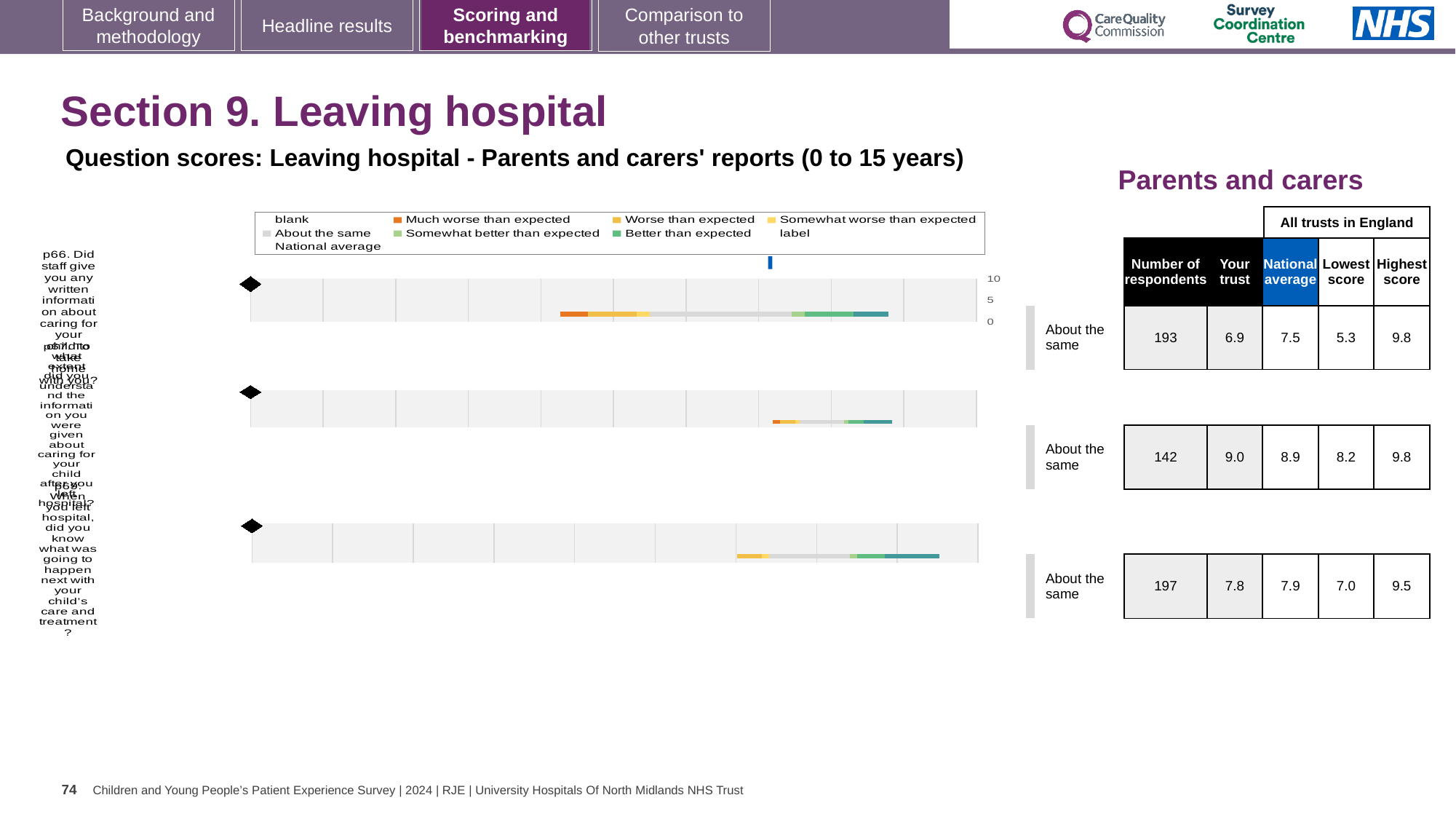
In the Parents and carers table, what is the difference between the highest score and the lowest score for the first question (193 respondents)? 4.5 In the Parents and carers table, what is the national average for the second question (142 respondents)? 8.9 In the Parents and carers table, what benchmark category is given for each of the three questions? About the same How many separate question charts are shown on the slide? 3 In the Parents and carers table, is the 'Your trust' score for the second question (142 respondents) larger or smaller than its national average? larger What kind of chart is used to show the question scores on this slide? bar chart Which legend entry is shown in orange? Much worse than expected What is the first entry listed in the chart legend? blank In the Parents and carers table, what is the highest score for the third question (197 respondents)? 9.5 In the Parents and carers table, how many respondents answered the third question? 197 In the Parents and carers table, what is the 'Your trust' score for the first question (193 respondents)? 6.9 In the Parents and carers table, which question has the lowest 'Your trust' score? the first question (193 respondents), 6.9